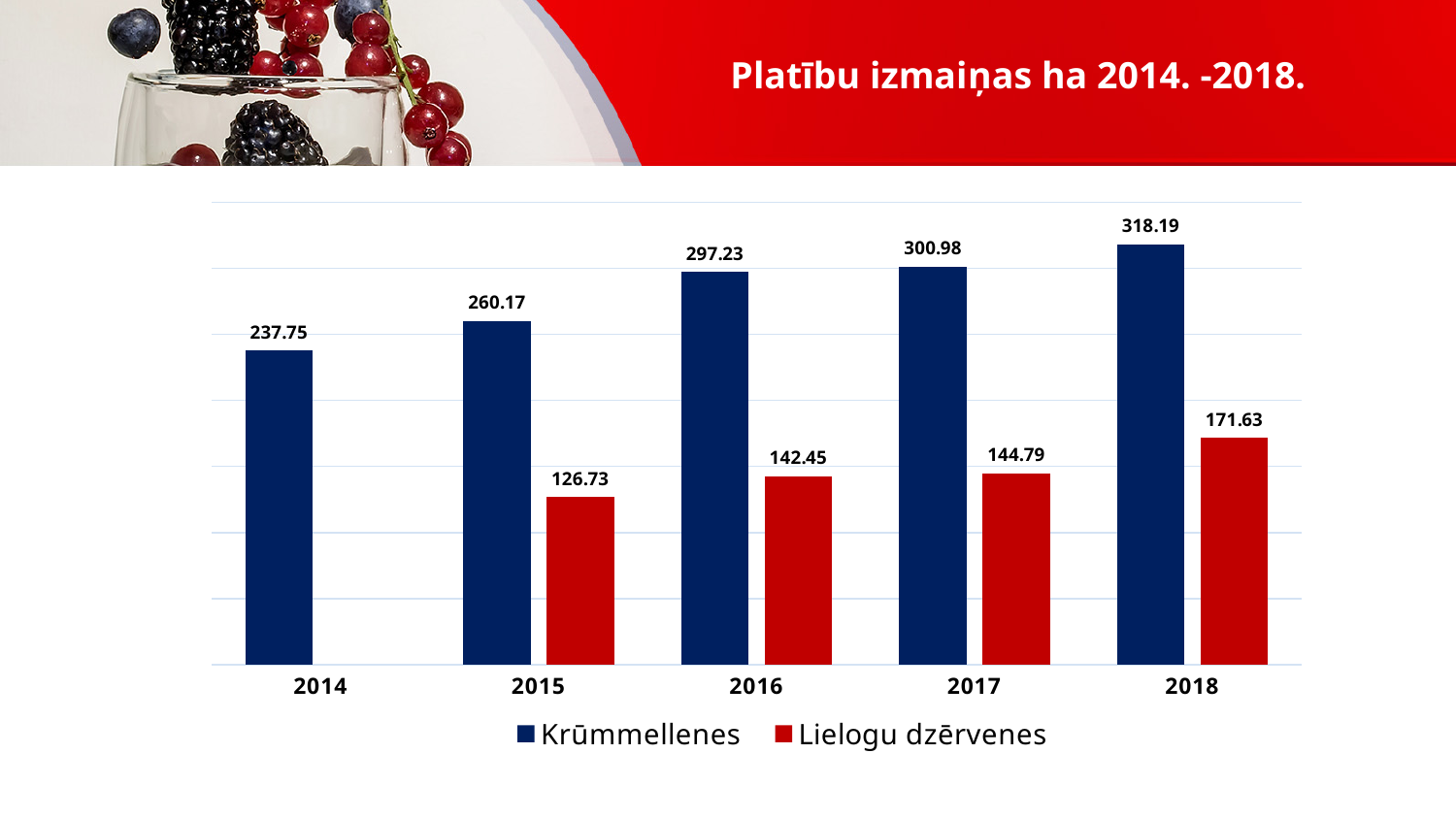
What is the difference between the Krūmmellenes and Lielogu dzērvenes values in 2018? 146.56 What is the value for Lielogu dzērvenes in 2015? 126.73 Which is larger in 2017: Krūmmellenes or Lielogu dzērvenes? Krūmmellenes In which year is the Krūmmellenes value highest? 2018 How many years are shown on the x axis? 5 By how much did the Krūmmellenes value increase from 2014 to 2015? 22.42 What kind of chart is shown on the slide? Bar chart What is the value for Krūmmellenes in 2014? 237.75 Do the Krūmmellenes values rise or fall from 2014 to 2018? Rise What is the value for Krūmmellenes in 2016? 297.23 In which year is the Lielogu dzērvenes value lowest? 2015 How many series does the legend list? 2